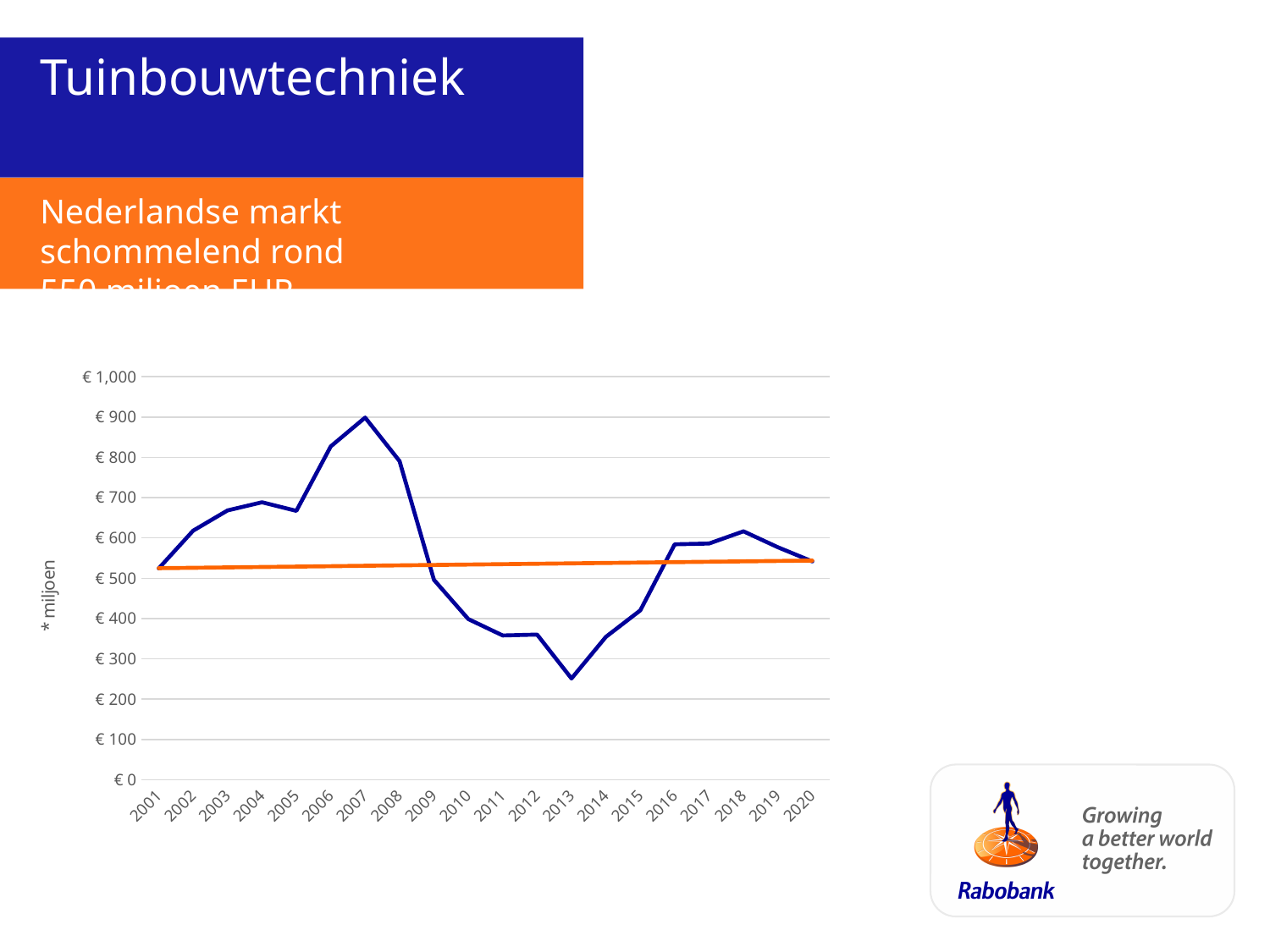
Which year has the larger value, 2006 or 2010? 2006 Is the value for 2013 greater or less than € 300? less Is the value for 2018 greater or less than € 500? greater Do the values of the blue line rise or fall between 2007 and 2013? fall In which year does the blue line reach its lowest value? 2013 Is the value for 2007 greater or less than € 800? greater What kind of chart is shown on the slide? line chart Do the values of the blue line rise or fall between 2013 and 2018? rise How many years are plotted along the x axis of the chart? 20 In which year does the blue line reach its highest value? 2007 What is the label on the vertical axis of the chart? * miljoen